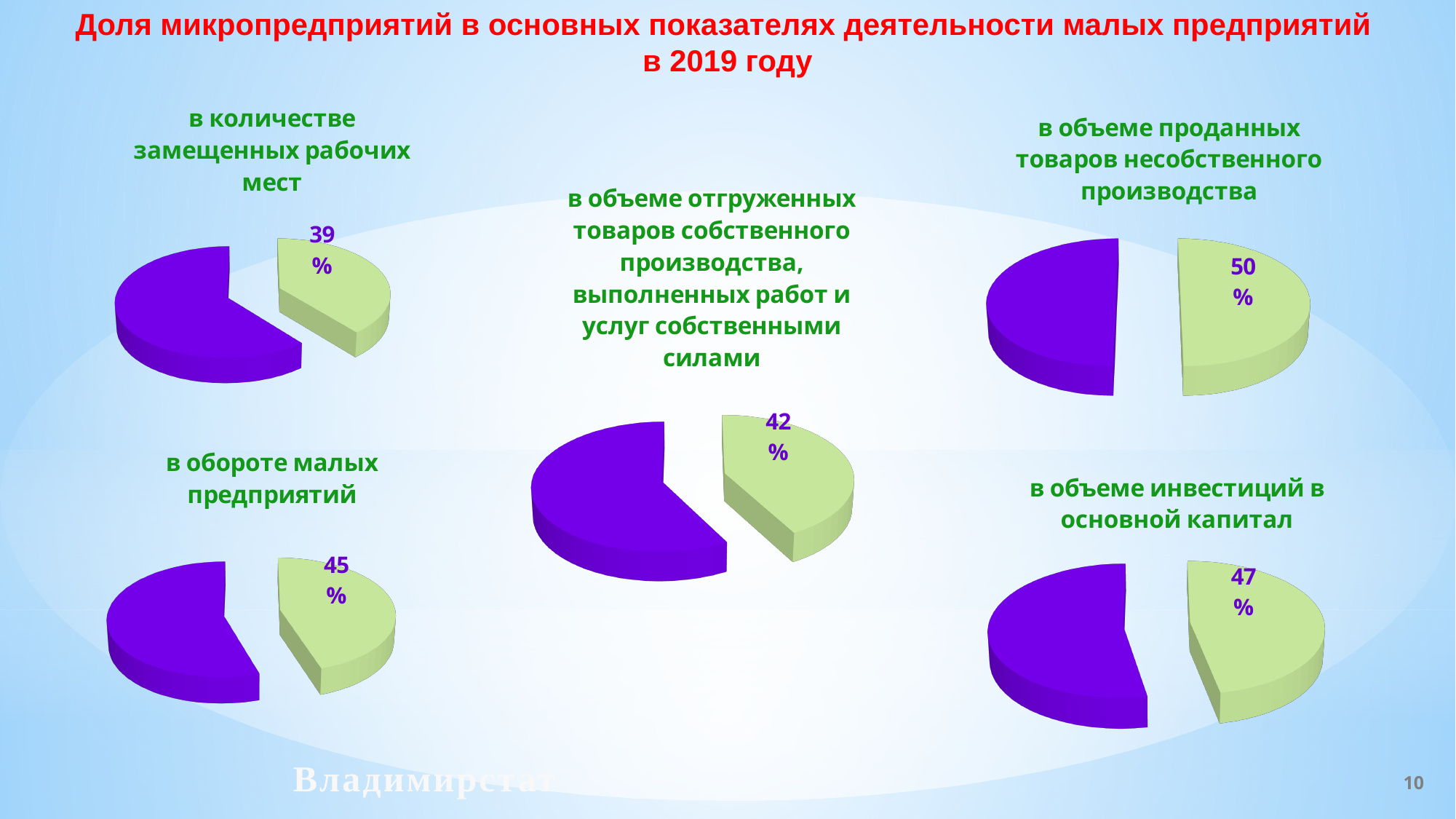
On the pie chart titled "в объеме проданных товаров несобственного производства", what value is printed on the green slice? 50% On the pie chart titled "в объеме инвестиций в основной капитал", what value is printed on the green slice? 47% What kind of chart is used for "в обороте малых предприятий"? pie chart On the pie chart titled "в обороте малых предприятий", what value is printed on the green slice? 45% Which of the five pie charts shows the highest labelled share for microenterprises? в объеме проданных товаров несобственного производства What is the difference between the labelled share on the "в объеме проданных товаров несобственного производства" chart and the labelled share on the "в количестве замещенных рабочих мест" chart? 11% Which labelled share is larger: the one on the "в обороте малых предприятий" chart or the one on the "в объеме инвестиций в основной капитал" chart? в объеме инвестиций в основной капитал On the pie chart titled "в количестве замещенных рабочих мест", what value is printed on the green slice? 39% How many pie charts are shown on the slide? 5 On the pie chart titled "в объеме отгруженных товаров собственного производства, выполненных работ и услуг собственными силами", what value is printed on the green slice? 42% Which of the five pie charts shows the lowest labelled share for microenterprises? в количестве замещенных рабочих мест What colour is the slice that carries the percentage label on each pie chart? light green